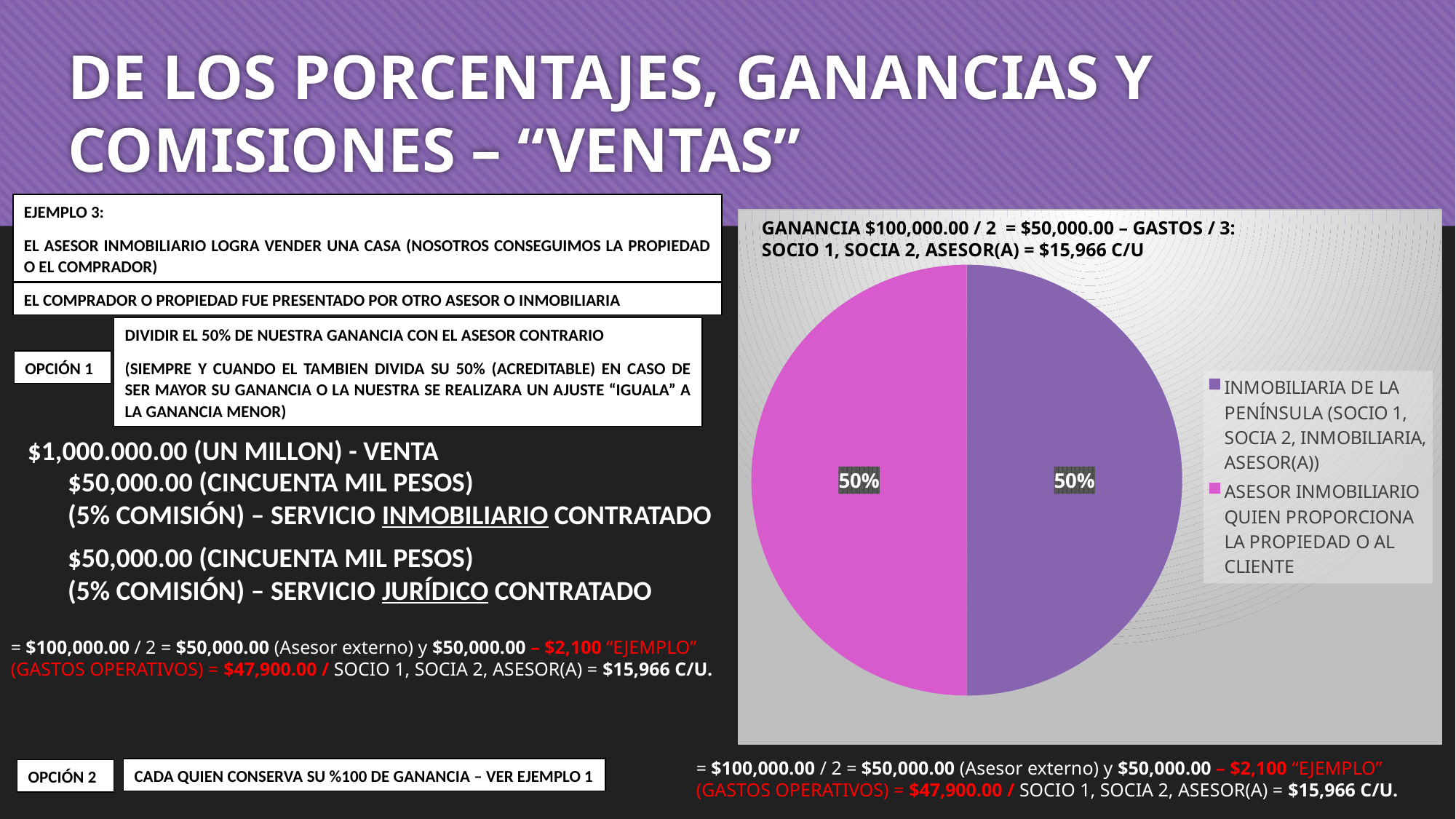
What percentage is shown for the slice labelled "ASESOR INMOBILIARIO QUIEN PROPORCIONA LA PROPIEDAD O AL CLIENTE"? 50% What kind of chart is shown on the slide? pie chart How many slices does the pie chart have? 2 What per-person amount (C/U) is stated in the pie chart's title? $15,966 What percentage is shown for the slice labelled "INMOBILIARIA DE LA PENÍNSULA (SOCIO 1, SOCIA 2, INMOBILIARIA, ASESOR(A))"? 50% What do the two slice percentages on the pie chart add up to? 100% Which colour is used for the "ASESOR INMOBILIARIO QUIEN PROPORCIONA LA PROPIEDAD O AL CLIENTE" slice? pink (magenta) Is the slice for "INMOBILIARIA DE LA PENÍNSULA" larger, smaller, or the same size as the slice for "ASESOR INMOBILIARIO QUIEN PROPORCIONA LA PROPIEDAD O AL CLIENTE"? the same size How many entries does the pie chart's legend list? 2 What is the difference between the two slice percentages shown on the pie chart? 0% What share of the pie does the "ASESOR INMOBILIARIO QUIEN PROPORCIONA LA PROPIEDAD O AL CLIENTE" slice represent? 50%